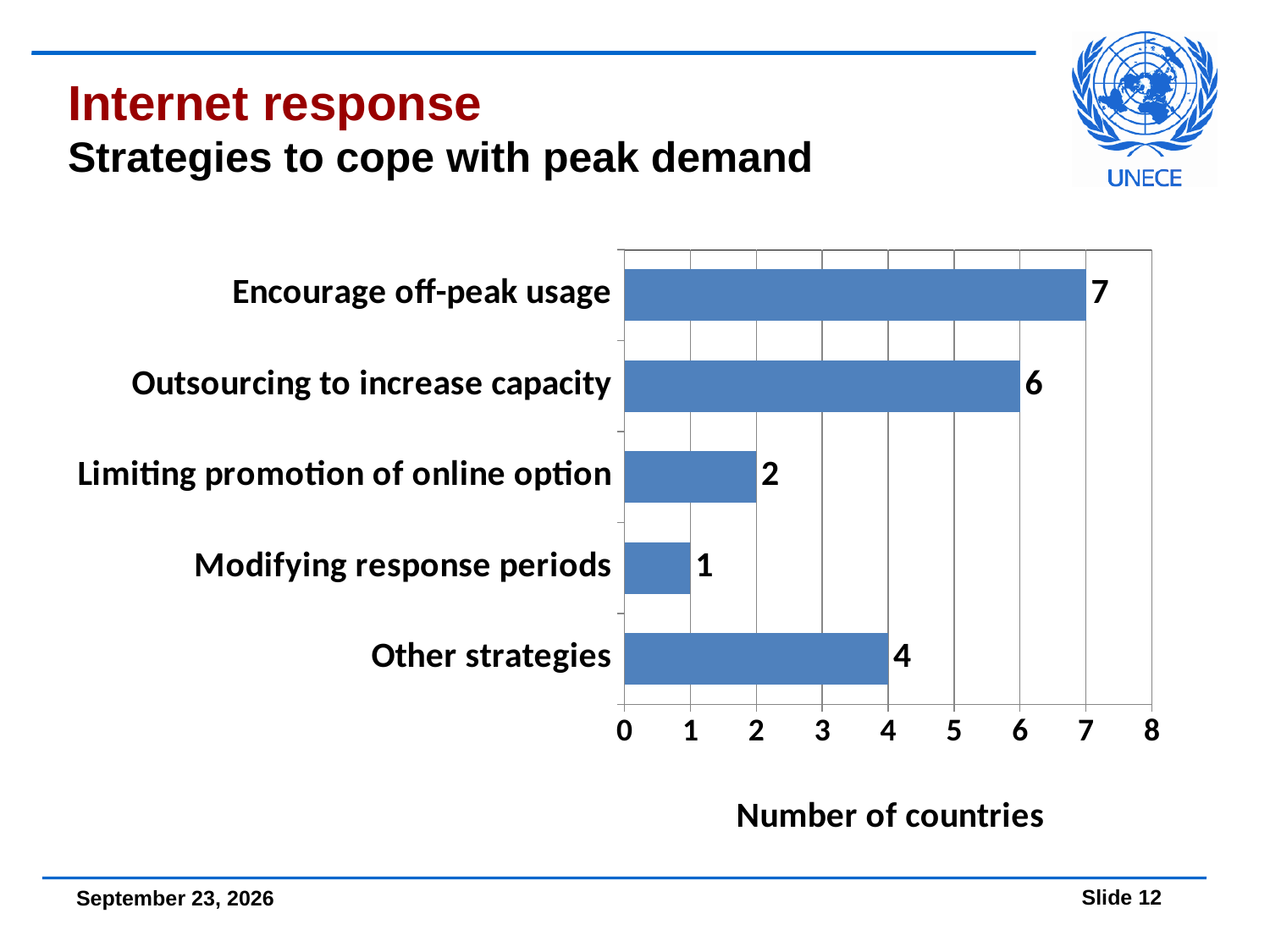
What is the maximum value shown on the horizontal axis? 8 Which has more countries: 'Outsourcing to increase capacity' or 'Limiting promotion of online option'? Outsourcing to increase capacity Which strategy has the highest number of countries? Encourage off-peak usage What is the number of countries for 'Other strategies'? 4 How many countries encourage off-peak usage as a strategy to cope with peak demand? 7 What is the number of countries for 'Outsourcing to increase capacity'? 6 What is the difference in number of countries between 'Encourage off-peak usage' and 'Other strategies'? 3 What is the label of the horizontal axis of the chart? Number of countries What is the number of countries for 'Limiting promotion of online option'? 2 Which strategy has the lowest number of countries? Modifying response periods How many strategies are shown in the chart? 5 What kind of chart is shown on the slide? Bar chart